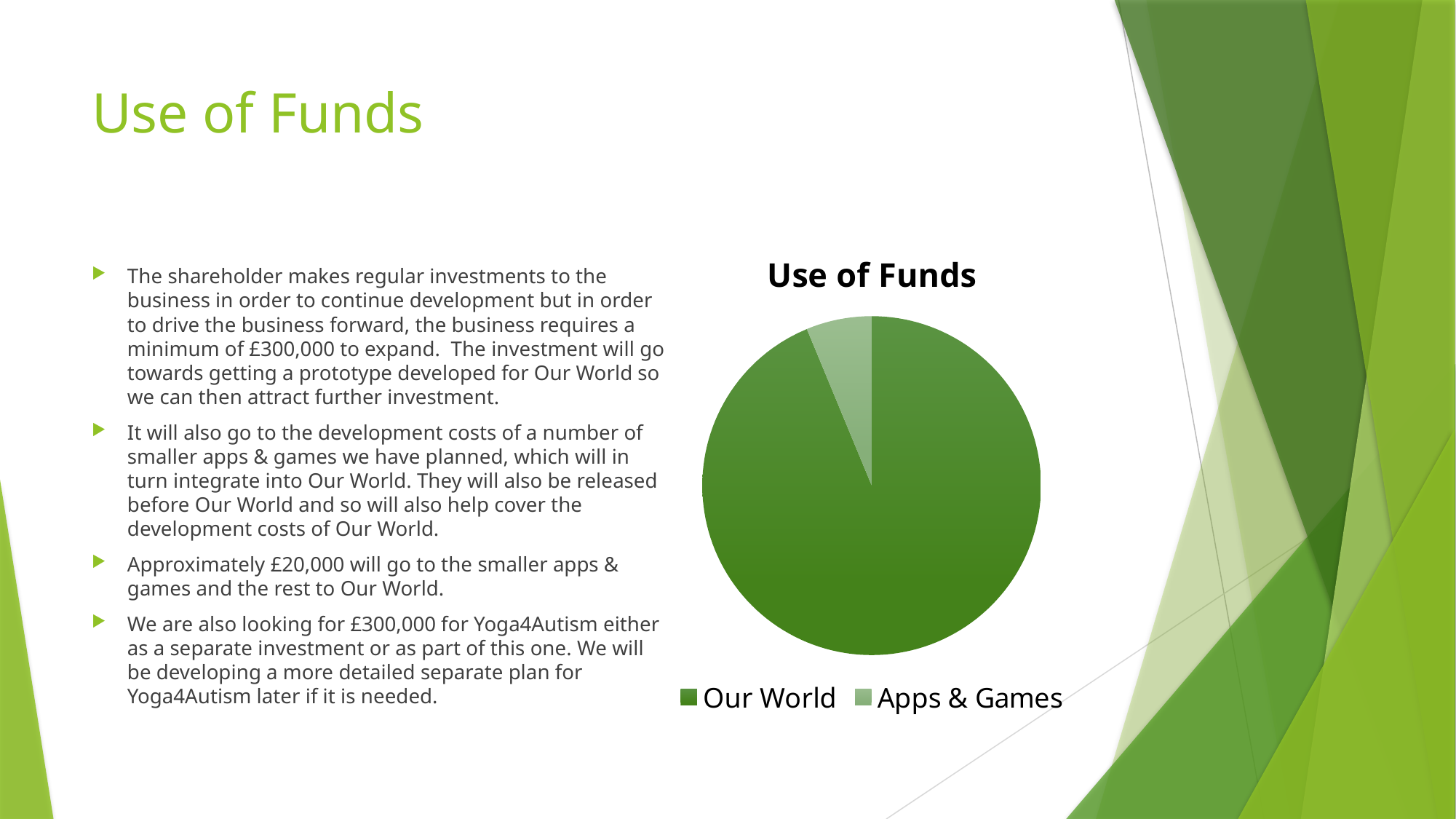
Does the Our World slice take up more or less than half of the pie? more Which category has the largest slice of the pie? Our World What is the title of the chart? Use of Funds How many slices does the pie chart have? 2 Which category is shown in the lighter green colour in the pie chart? Apps & Games How many entries does the chart legend list? 2 Which slice is larger, Our World or Apps & Games? Our World What kind of chart is shown on the slide? pie chart Which category has the smallest slice of the pie? Apps & Games